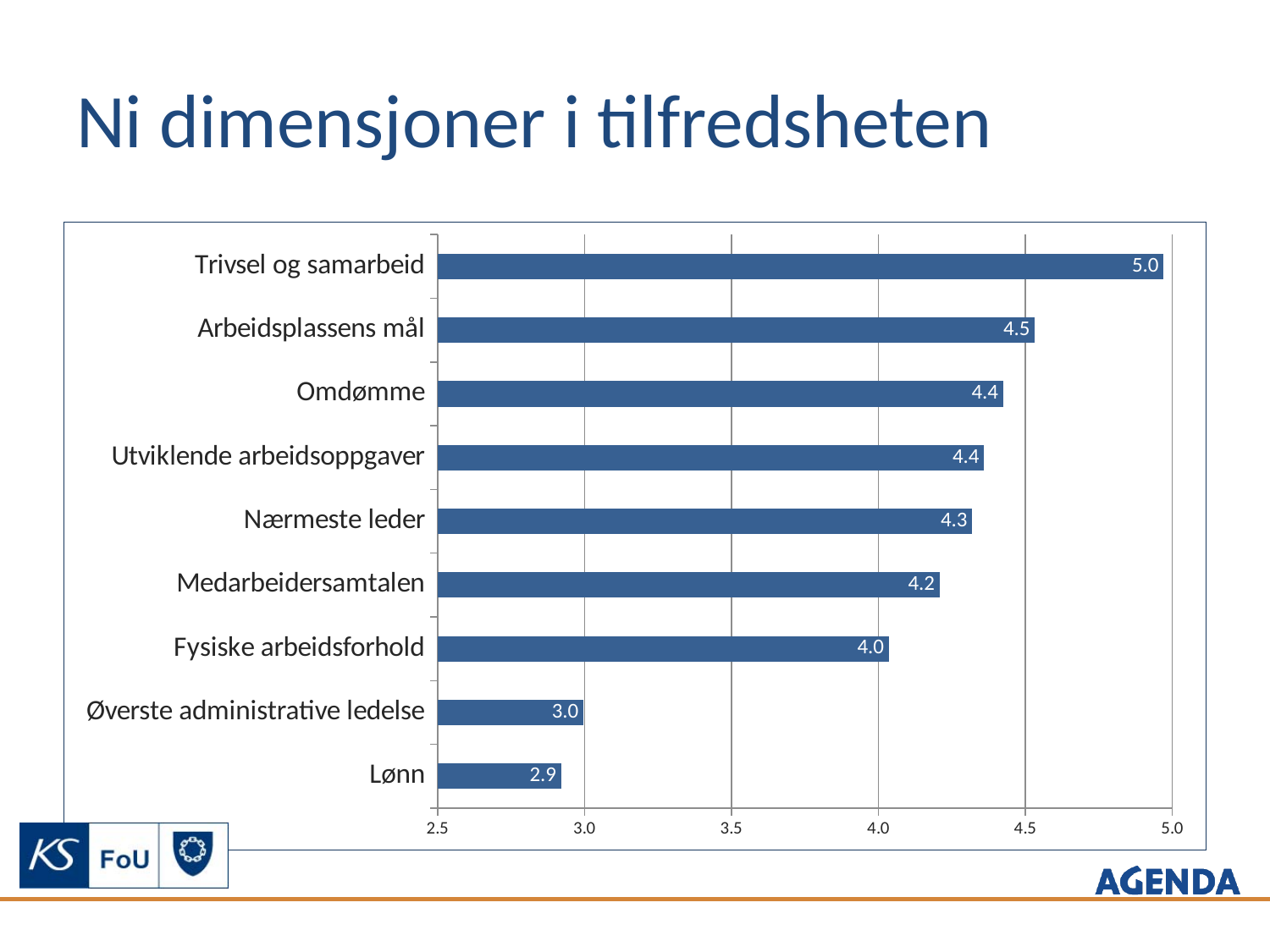
What is the difference between the values for Arbeidsplassens mål and Medarbeidersamtalen? 0.3 Which category has the highest value? Trivsel og samarbeid What kind of chart is shown on the slide? Bar chart What is the value for Lønn? 2.9 Which category has the lowest value? Lønn How many categories are shown in the chart? 9 Which is larger, the value for Øverste administrative ledelse or the value for Fysiske arbeidsforhold? Fysiske arbeidsforhold What is the title of the slide? Ni dimensjoner i tilfredsheten What is the value for Nærmeste leder? 4.3 What is the difference between the values for Trivsel og samarbeid and Lønn? 2.1 What is the value for Trivsel og samarbeid? 5.0 What is the value for Fysiske arbeidsforhold? 4.0